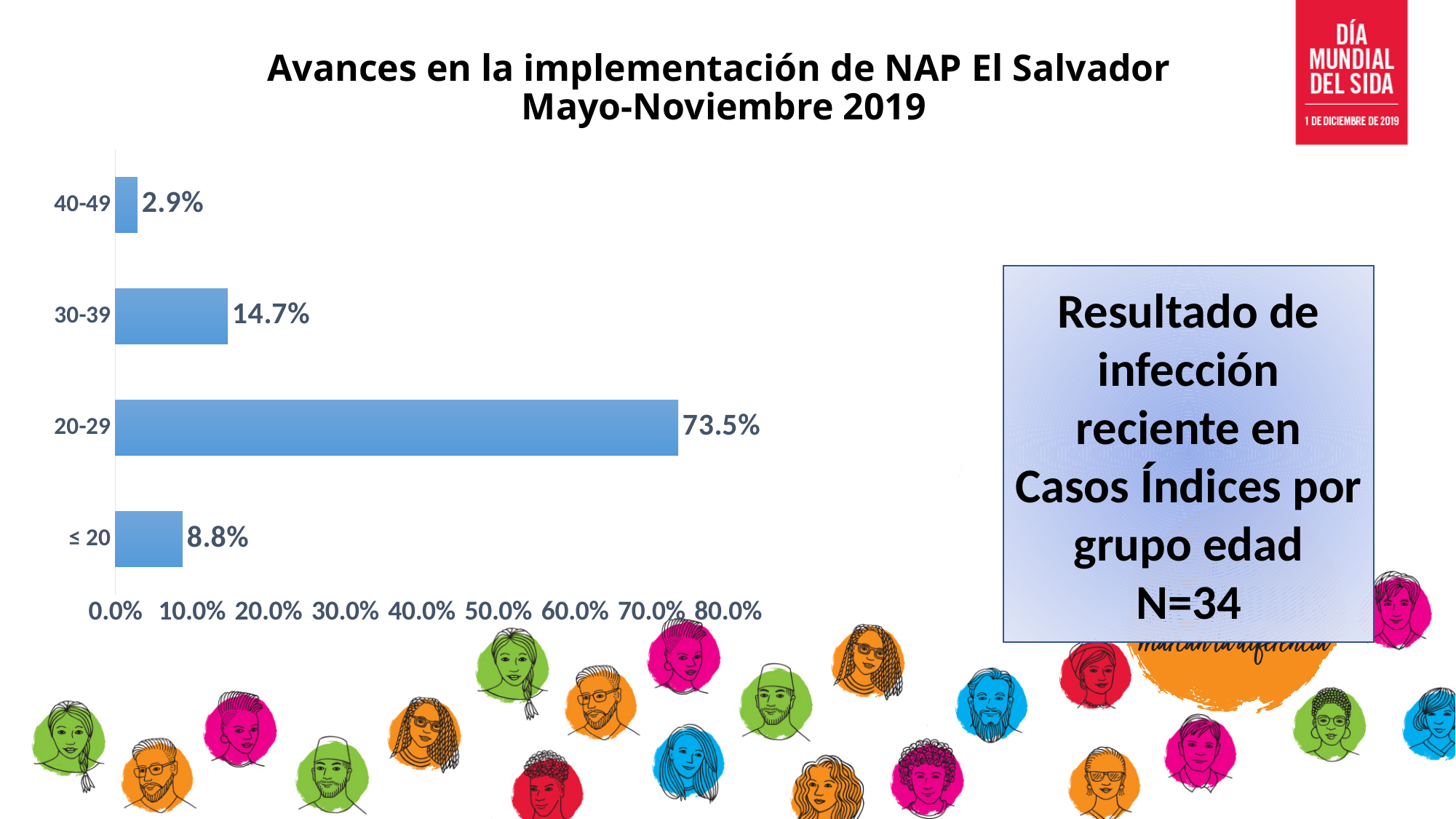
What is the value for the ≤ 20 age group? 8.8% Is the value for 20-29 greater or less than 70.0%? greater What is the difference between the values for ≤ 20 and 40-49? 5.9% How many age groups are shown in the chart? 4 Which age group has the highest value? 20-29 What kind of chart is shown on the slide? bar chart Which age group has the lowest value? 40-49 What is the difference between the values for 20-29 and 30-39? 58.8% What is the value for the 20-29 age group? 73.5% What is the value for the 40-49 age group? 2.9% What is the value for the 30-39 age group? 14.7% Which is larger, the value for 30-39 or the value for ≤ 20? 30-39